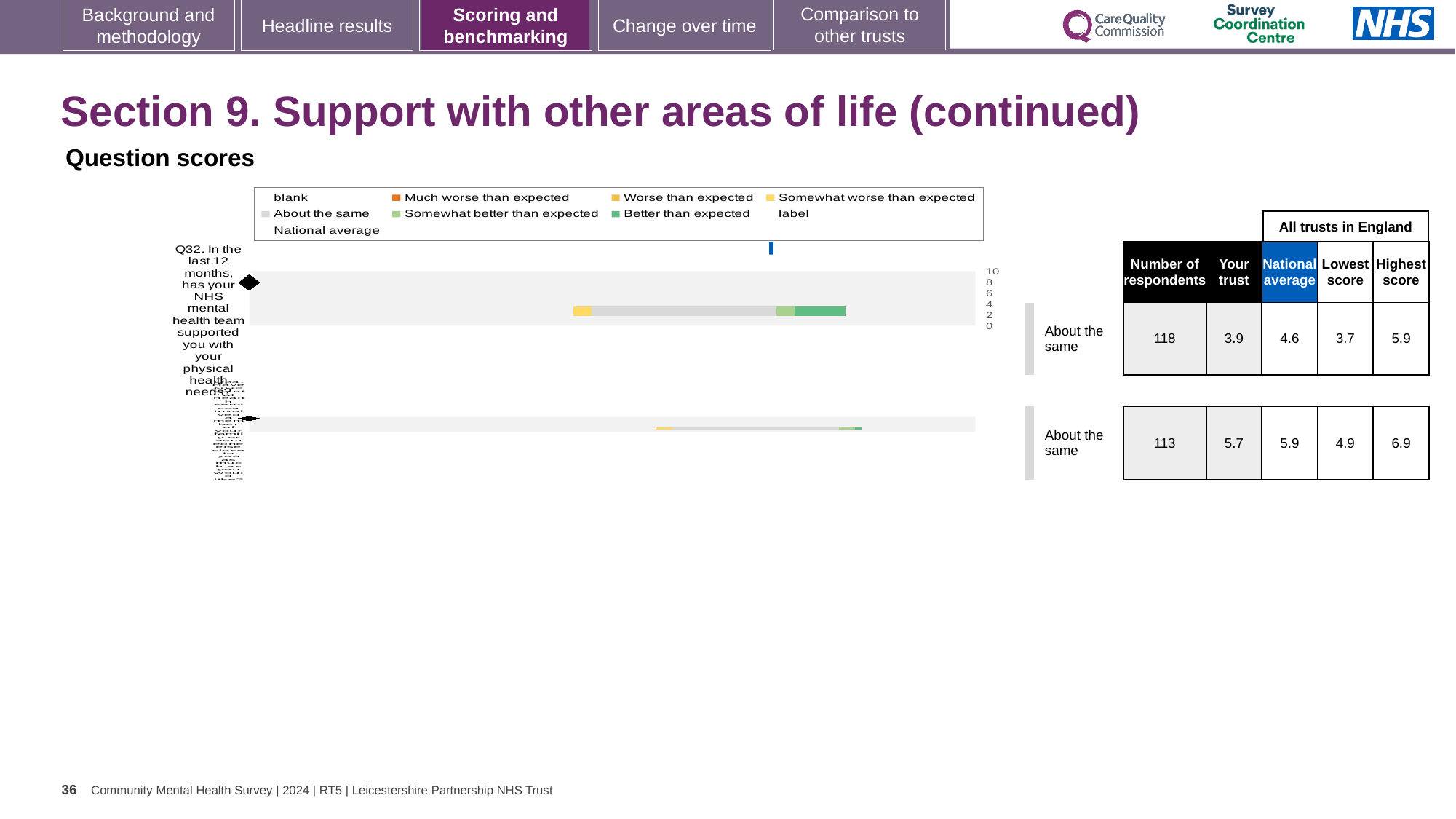
What benchmark category is shown for Q32? About the same What is the 'Your trust' score for Q32 (support with physical health needs)? 3.9 How many respondents answered Q32? 118 For Q32, which is higher: the trust's score or the national average? National average What is the maximum value shown on the chart's score axis? 10 What is the lowest score among all trusts in England for Q32? 3.7 For Q32, what is the difference between the highest and lowest scores across all trusts in England? 2.2 What type of chart is shown on the slide? bar chart How many question bars are plotted in the chart? 2 For Q32, what is the difference between the national average and the trust's score? 0.7 What is the national average score for Q32? 4.6 What is the highest score among all trusts in England for Q32? 5.9